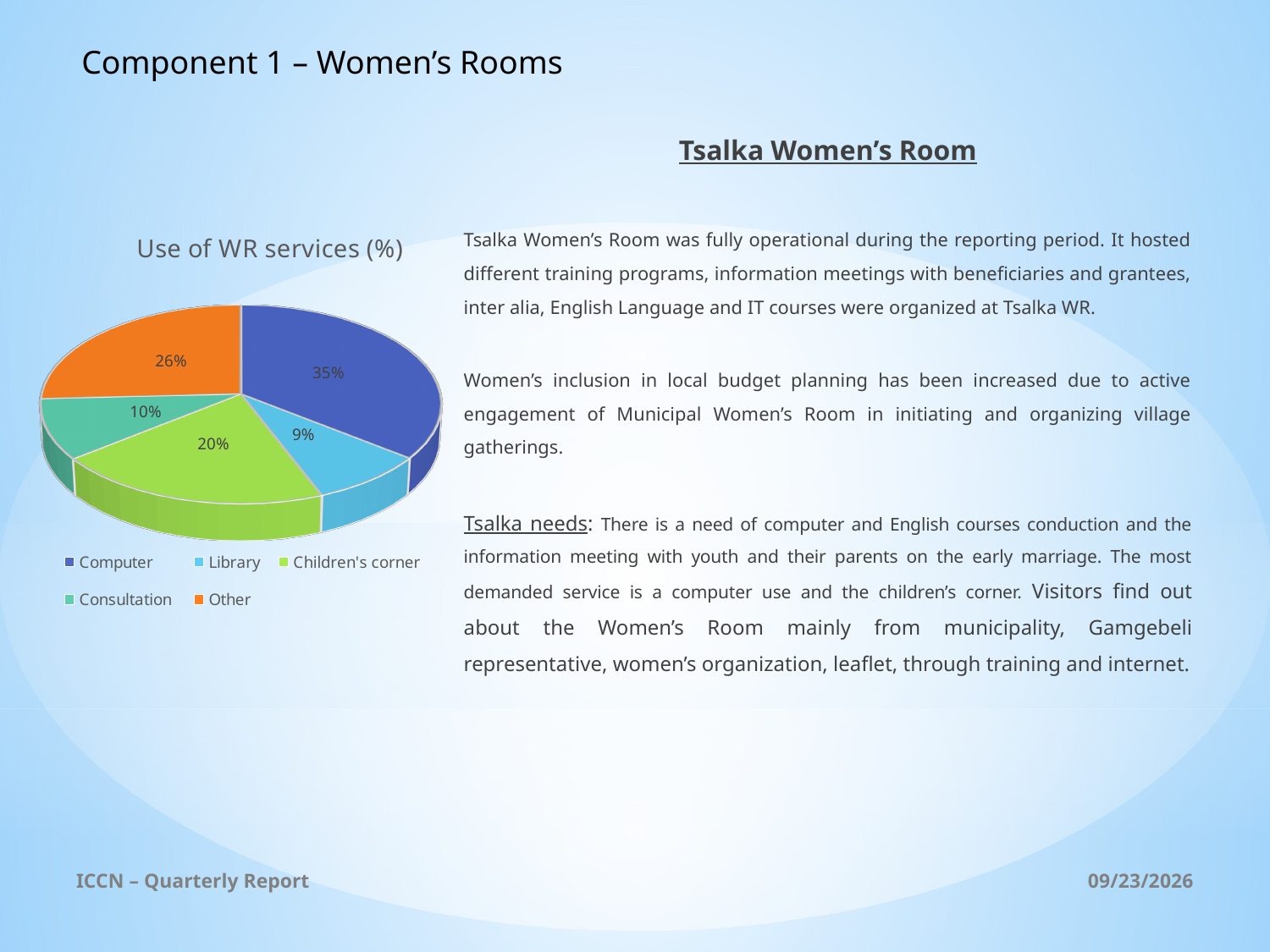
What percentage of WR service use is Consultation? 10% Which service has the smallest share of the pie? Library What percentage of WR service use is Other? 26% What percentage of WR service use is Computer? 35% What is the title of the chart? Use of WR services (%) Which has a larger share, Children's corner or Consultation? Children's corner What kind of chart is shown on the slide? pie chart What is the difference in percentage points between Computer and Other? 9 Which service has the largest share of the pie? Computer What percentage of WR service use is Library? 9% What percentage of WR service use is Children's corner? 20% How many categories does the legend list? 5